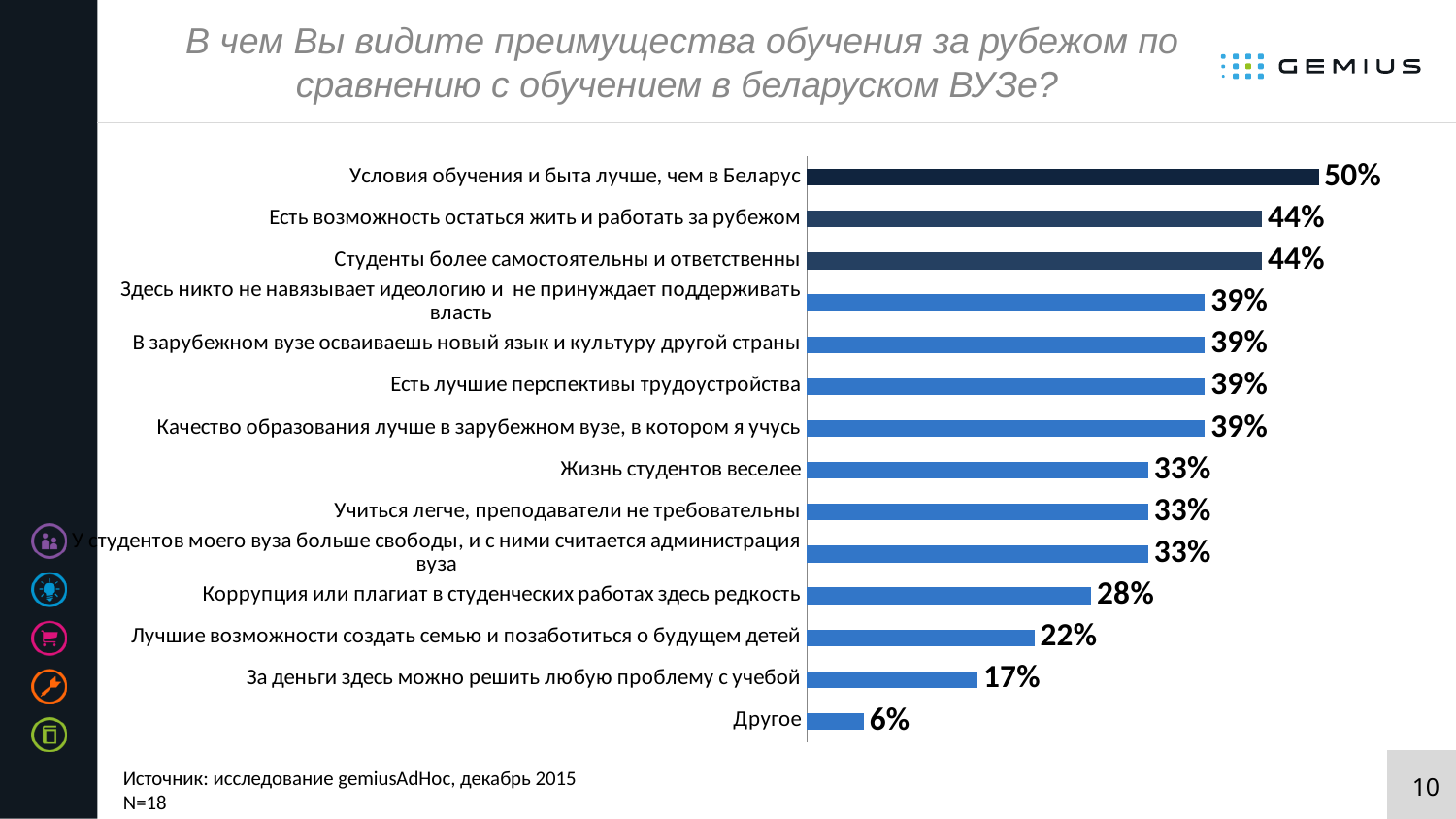
What is the sample size (N) stated on the slide? N=18 What is the difference between the values for "Есть возможность остаться жить и работать за рубежом" and "Лучшие возможности создать семью и позаботиться о будущем детей"? 22% What kind of chart is shown on the slide? Bar chart Which is larger: the value for "Есть лучшие перспективы трудоустройства" or the value for "Учиться легче, преподаватели не требовательны"? Есть лучшие перспективы трудоустройства How many categories are shown in the chart? 14 Which category has the highest value? Условия обучения и быта лучше, чем в Беларус What is the value for "Коррупция или плагиат в студенческих работах здесь редкость"? 28% Which category has the lowest value? Другое What is the difference between the values for "Условия обучения и быта лучше, чем в Беларус" and "Другое"? 44% What is the value for "Жизнь студентов веселее"? 33% What is the value for "За деньги здесь можно решить любую проблему с учебой"? 17% What is the value for "Условия обучения и быта лучше, чем в Беларус"? 50%